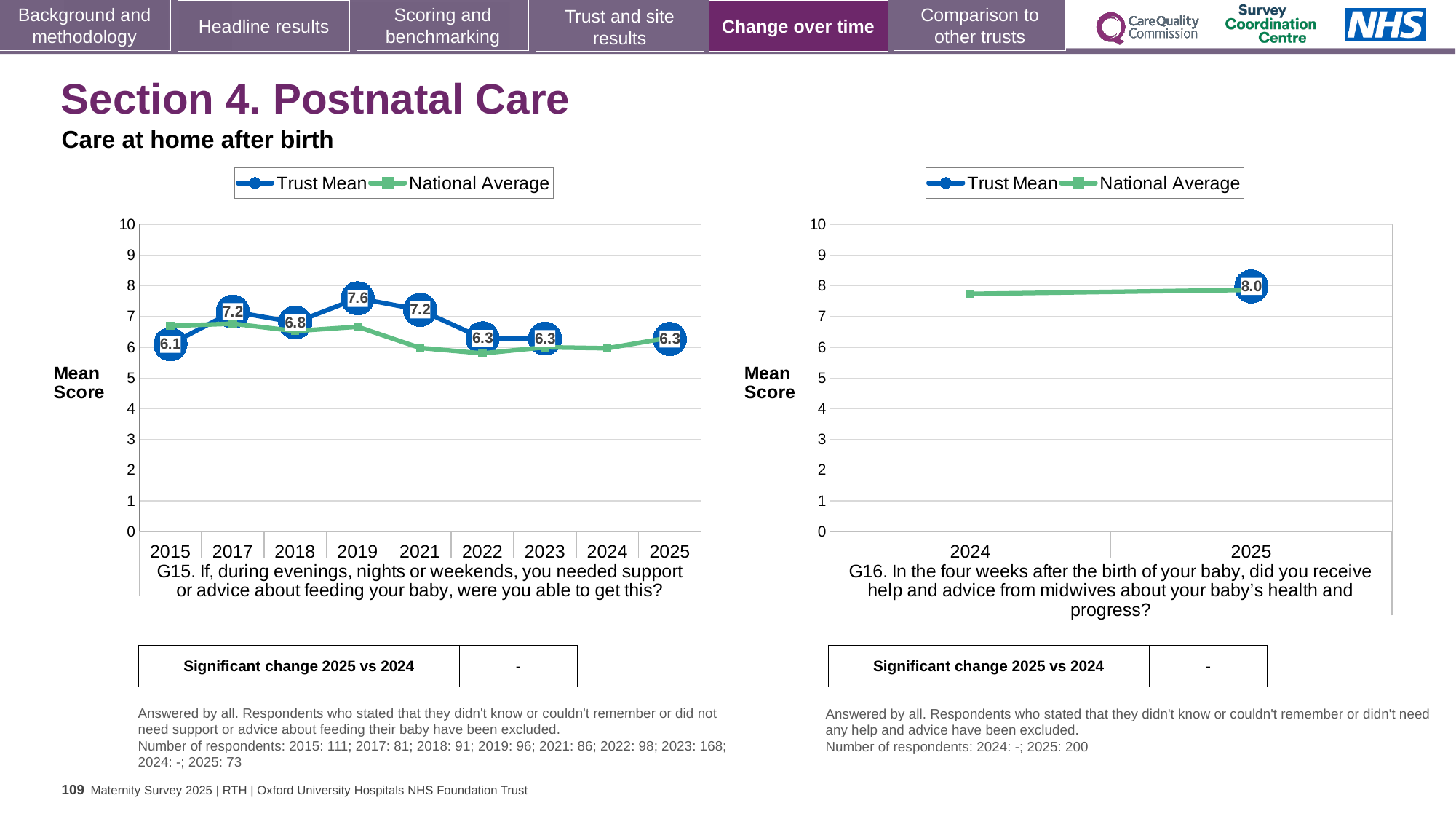
In the left chart (G15), what is the Trust Mean score for 2015? 6.1 In the right chart (G16), is the National Average value for 2024 greater or less than 7? greater In the right chart (G16), what is the Trust Mean score for 2025? 8.0 What kind of chart is the left chart (G15)? line chart In the left chart (G15), does the Trust Mean score rise or fall from 2019 to 2022? fall In the left chart (G15), which year has the highest Trust Mean score? 2019 In the left chart (G15), what is the Trust Mean score for 2019? 7.6 In the left chart (G15), which year has the higher Trust Mean score, 2017 or 2018? 2017 In the left chart (G15), which year has the lowest Trust Mean score? 2015 How many series does the legend of the left chart (G15) list? 2 In the left chart (G15), what is the difference between the Trust Mean scores for 2019 and 2015? 1.5 How many years are shown on the x axis of the left chart (G15)? 9